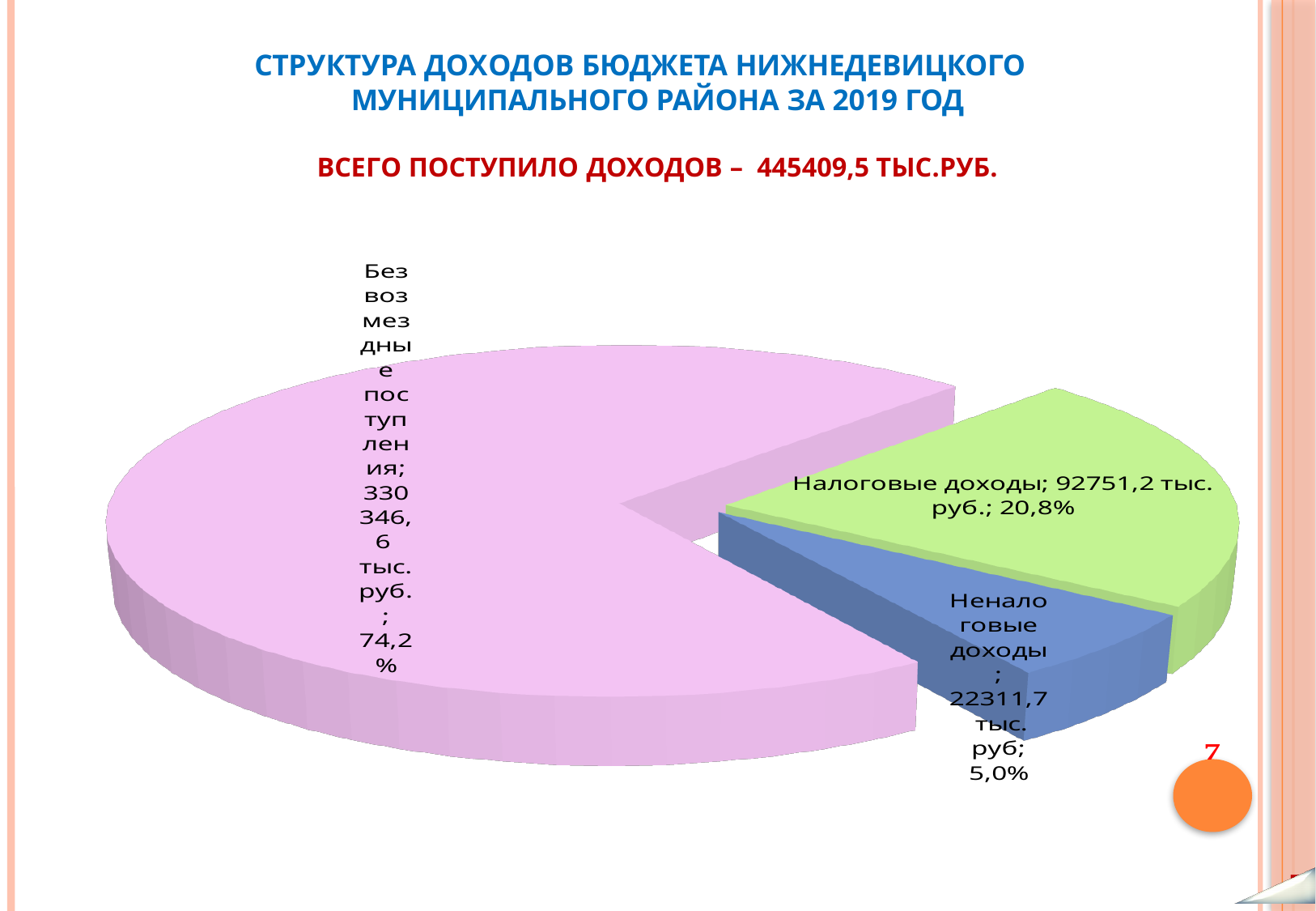
What share of the pie does Неналоговые доходы represent? 5,0% Which category has the smallest slice of the pie? Неналоговые доходы What kind of chart is shown on the slide? pie chart What is the value for Налоговые доходы? 92751,2 тыс. руб. What is the difference between Налоговые доходы and Неналоговые доходы in тыс. руб.? 70439,5 Which category has the largest slice of the pie? Безвозмездные поступления What colour is the slice for Налоговые доходы? green What is the value for Неналоговые доходы? 22311,7 тыс. руб Which is larger, Налоговые доходы or Неналоговые доходы? Налоговые доходы What share of the pie does Налоговые доходы represent? 20,8% What is the value for Безвозмездные поступления? 330346,6 тыс. руб. How many slices does the pie chart have? 3